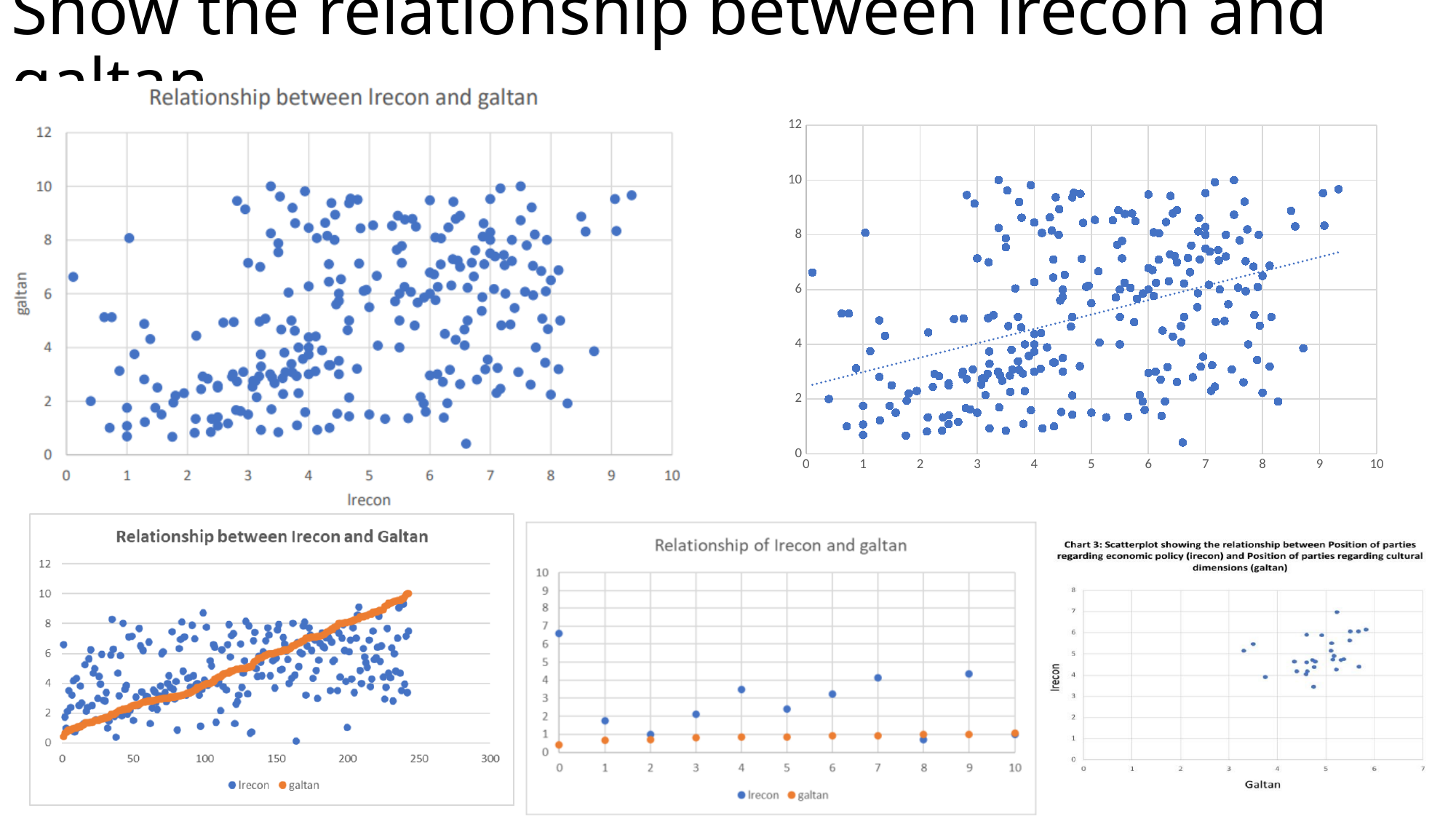
In the bottom-left chart titled "Relationship between lrecon and Galtan", do the orange galtan values rise or fall along the x axis? rise What is the x-axis label of the top-left chart titled "Relationship between lrecon and galtan"? lrecon In the bottom-middle chart titled "Relationship of lrecon and galtan", is the lrecon value at x = 0 greater or less than 6? greater How many series does the legend list in the bottom-middle chart titled "Relationship of lrecon and galtan"? 2 In the bottom-middle chart titled "Relationship of lrecon and galtan", at x = 9, which series has the larger value, lrecon or galtan? lrecon What is the y-axis label of the top-left chart titled "Relationship between lrecon and galtan"? galtan In the top-right scatter chart with the dotted trend line, does the trend line rise or fall as the x value increases? rise What kind of chart is the top-left chart titled "Relationship between lrecon and galtan"? scatter chart In the bottom-left chart titled "Relationship between lrecon and Galtan", which series is shown in orange? galtan How many series does the legend list in the bottom-left chart titled "Relationship between lrecon and Galtan"? 2 In the bottom-middle chart titled "Relationship of lrecon and galtan", is the galtan value at x = 5 greater or less than 2? less